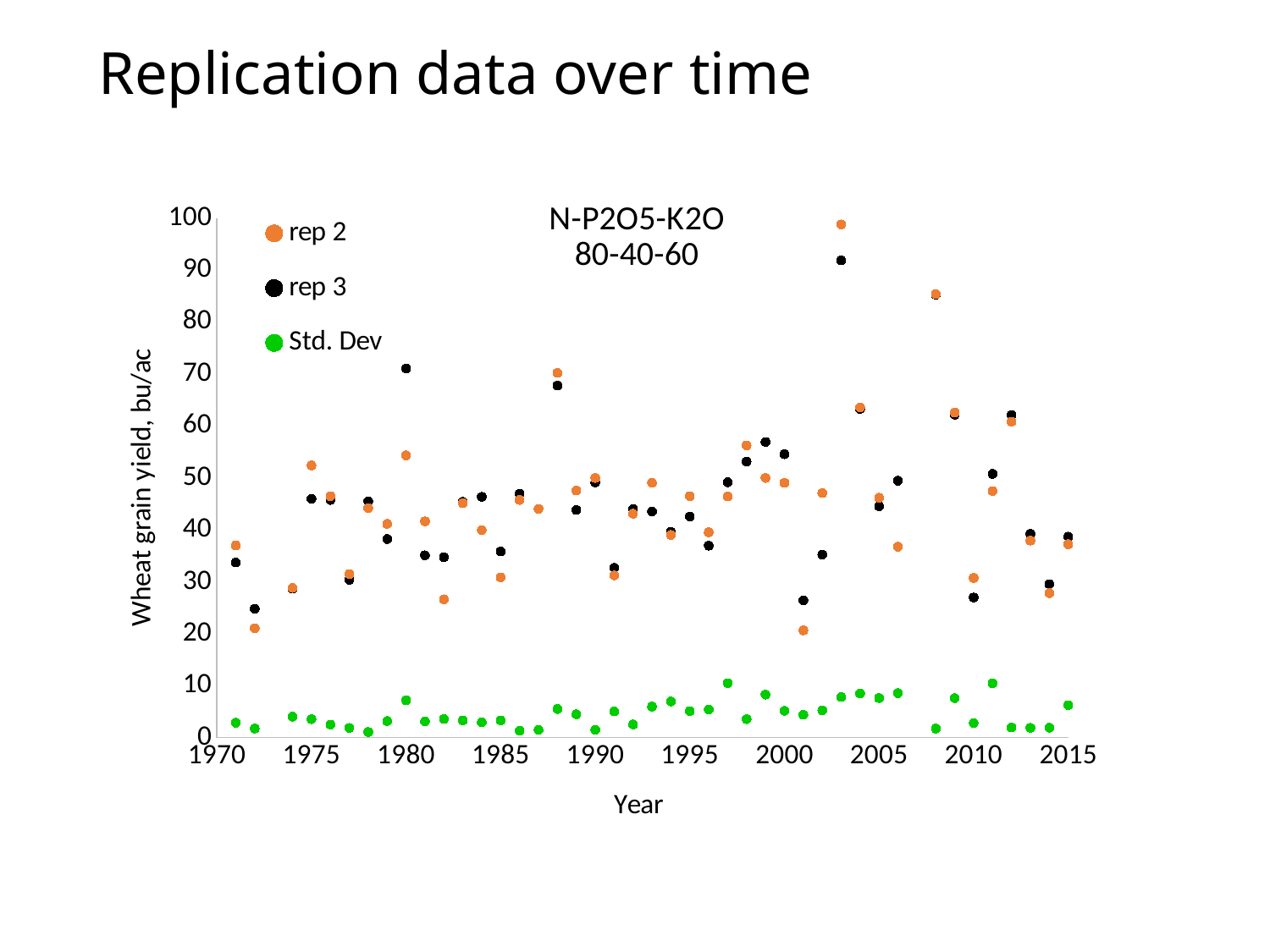
What is the label of the y axis? Wheat grain yield, bu/ac Is the rep 2 value in 2003 greater or less than 90? greater How many series does the legend list? 3 In which year does rep 3 reach its highest value? 2003 What fertilizer treatment is given in the chart's title? N-P2O5-K2O 80-40-60 Is the rep 3 value in 1972 greater or less than 30? less In 1980, which is larger, the rep 2 value or the rep 3 value? rep 3 Is the rep 2 value in 2001 greater or less than 30? less In 2003, which is larger, the rep 2 value or the rep 3 value? rep 2 What kind of chart is shown on the slide? scatter chart In which year does rep 2 reach its highest value? 2003